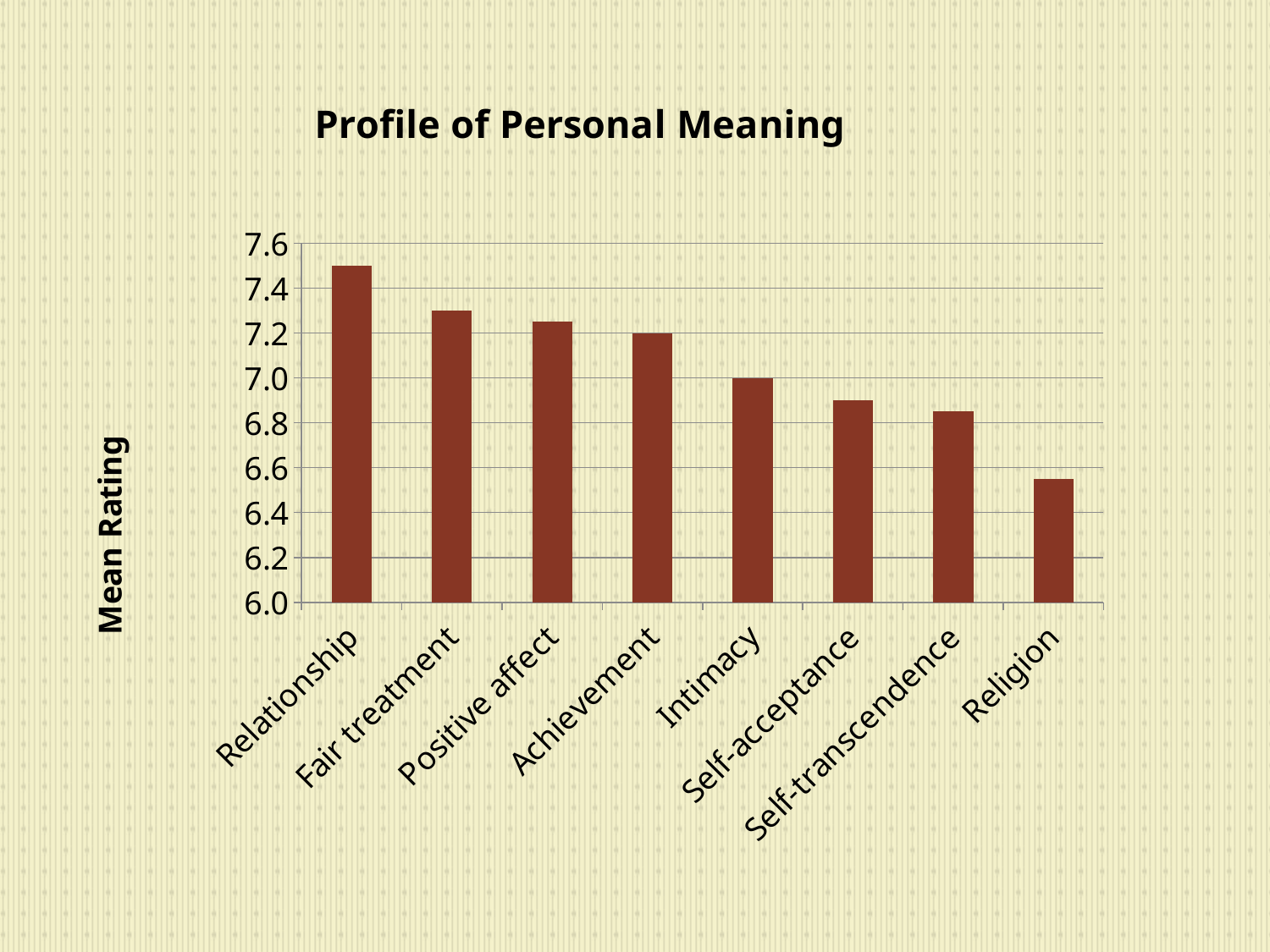
What kind of chart is shown on the slide? bar chart How many categories are shown on the x axis of the chart? 8 Is the mean rating for Relationship greater or less than 7.4? greater What is the title of the chart? Profile of Personal Meaning Is the mean rating for Religion greater or less than 6.6? less Is the mean rating for Fair treatment greater or less than 7.2? greater Which category has the lowest mean rating? Religion Which has a higher mean rating, Fair treatment or Intimacy? Fair treatment What is the label on the vertical axis of the chart? Mean Rating Which category has the highest mean rating? Relationship Do the mean ratings rise or fall from left to right across the categories? fall